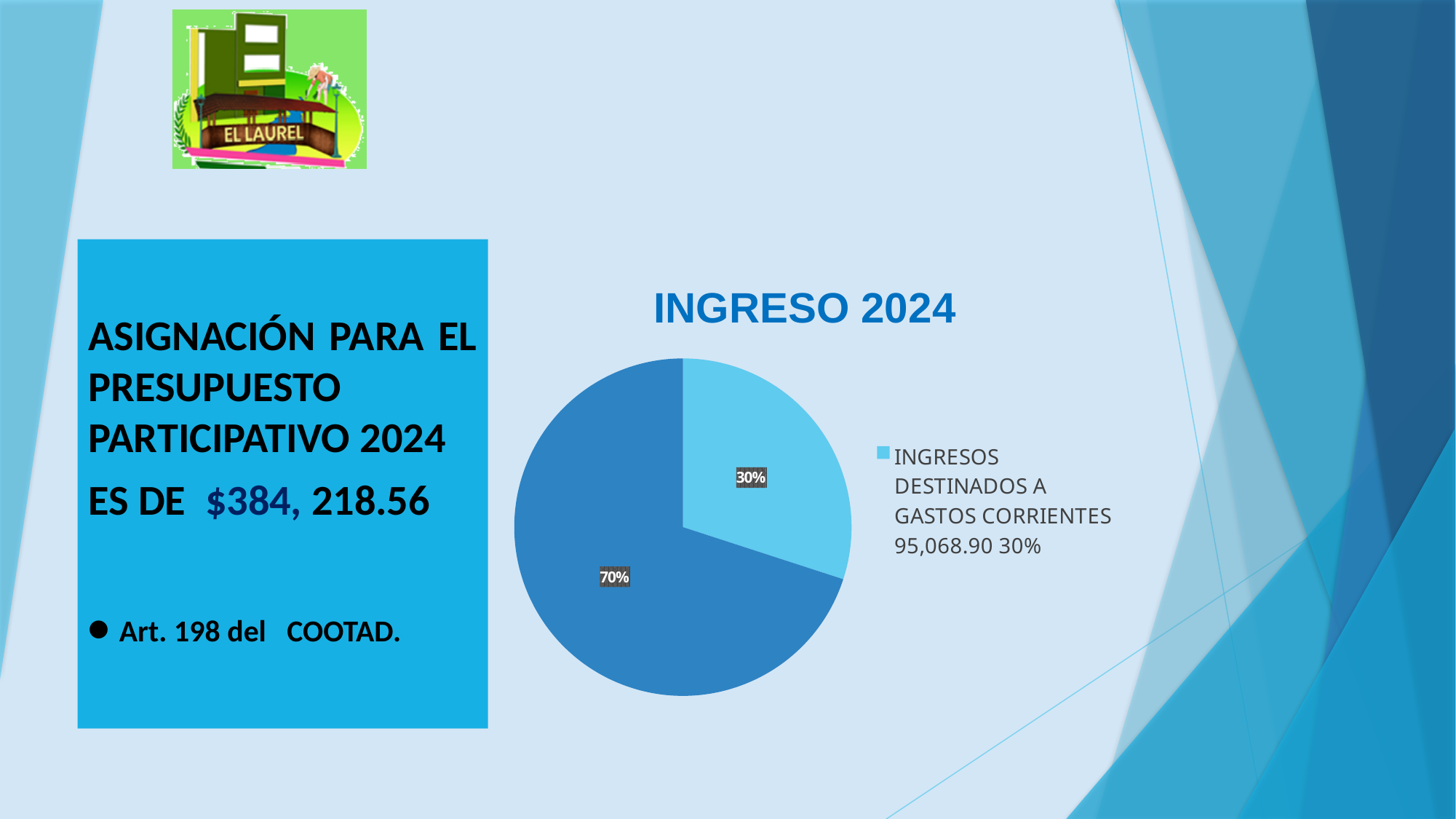
How many slices does the pie chart have? 2 What colour is the slice for INGRESOS DESTINADOS A GASTOS CORRIENTES? light blue Is the share for INGRESOS DESTINADOS A GASTOS CORRIENTES greater or less than 50%? less What kind of chart is shown on the slide? pie chart What is the title of the chart? INGRESO 2024 What percentage is shown on the smaller slice of the pie chart? 30% Which slice is larger: the one labelled 70% or the one labelled 30%? 70% What is the difference in percentage points between the two slices of the pie chart? 40 What is the total of the two percentages shown on the pie chart? 100% What percentage is shown on the larger slice of the pie chart? 70% How many entries does the legend of the pie chart list? 1 What share of the pie is labelled for INGRESOS DESTINADOS A GASTOS CORRIENTES? 30%